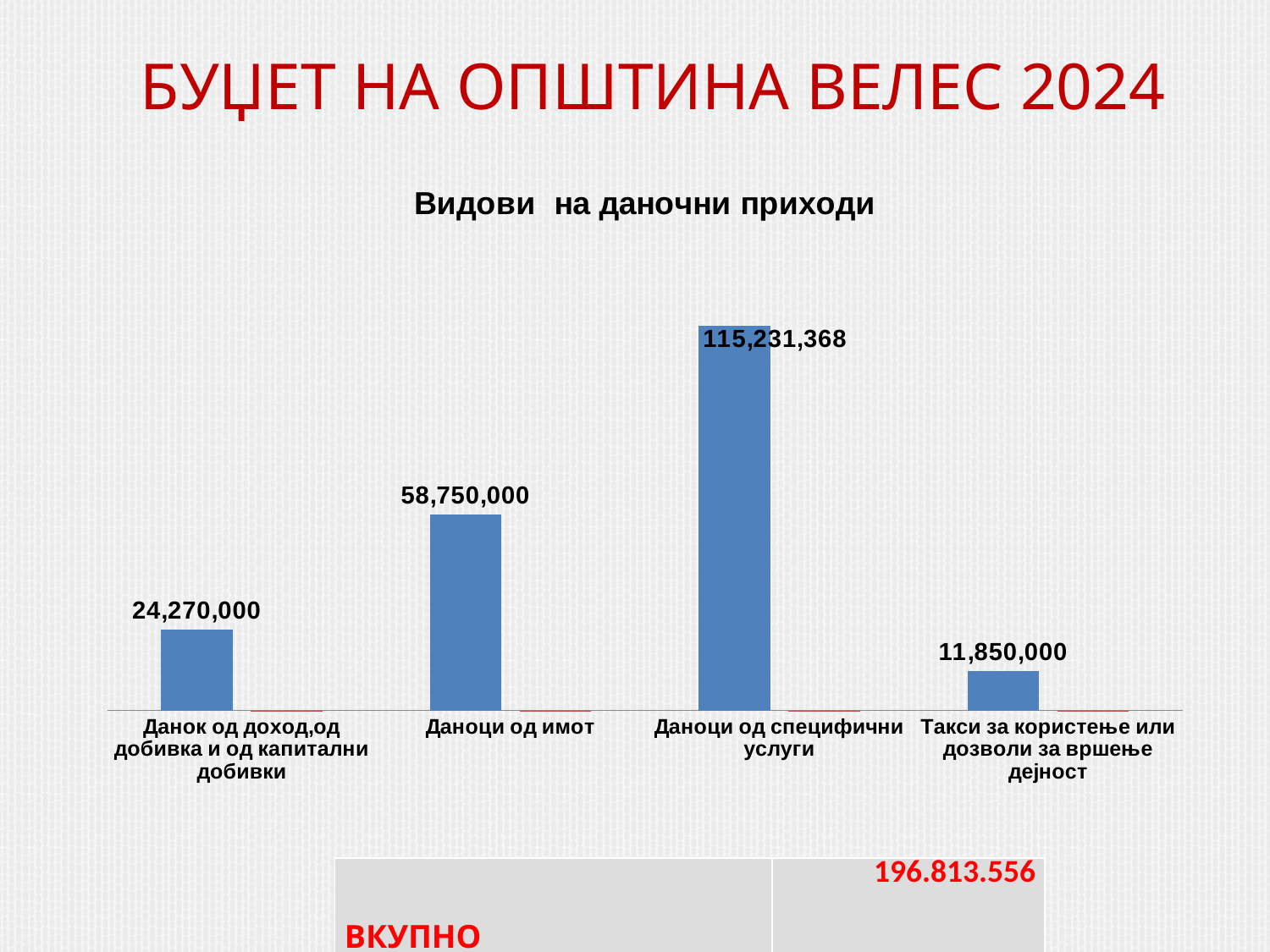
What is the title of the chart? Видови на даночни приходи Which category has the highest value? Даноци од специфични услуги What is the value for Такси за користење или дозволи за вршење дејност? 11,850,000 What is the difference between Даноци од специфични услуги and Даноци од имот? 56,481,368 What is the value for Данок од доход, од добивка и од капитални добивки? 24,270,000 How many categories are shown in the chart? 4 What is the value for Даноци од специфични услуги? 115,231,368 What is the difference between Даноци од имот and Данок од доход, од добивка и од капитални добивки? 34,480,000 What kind of chart is shown on the slide? Bar chart Which category has the lowest value? Такси за користење или дозволи за вршење дејност Which is larger: Данок од доход, од добивка и од капитални добивки or Такси за користење или дозволи за вршење дејност? Данок од доход, од добивка и од капитални добивки What is the value for Даноци од имот? 58,750,000